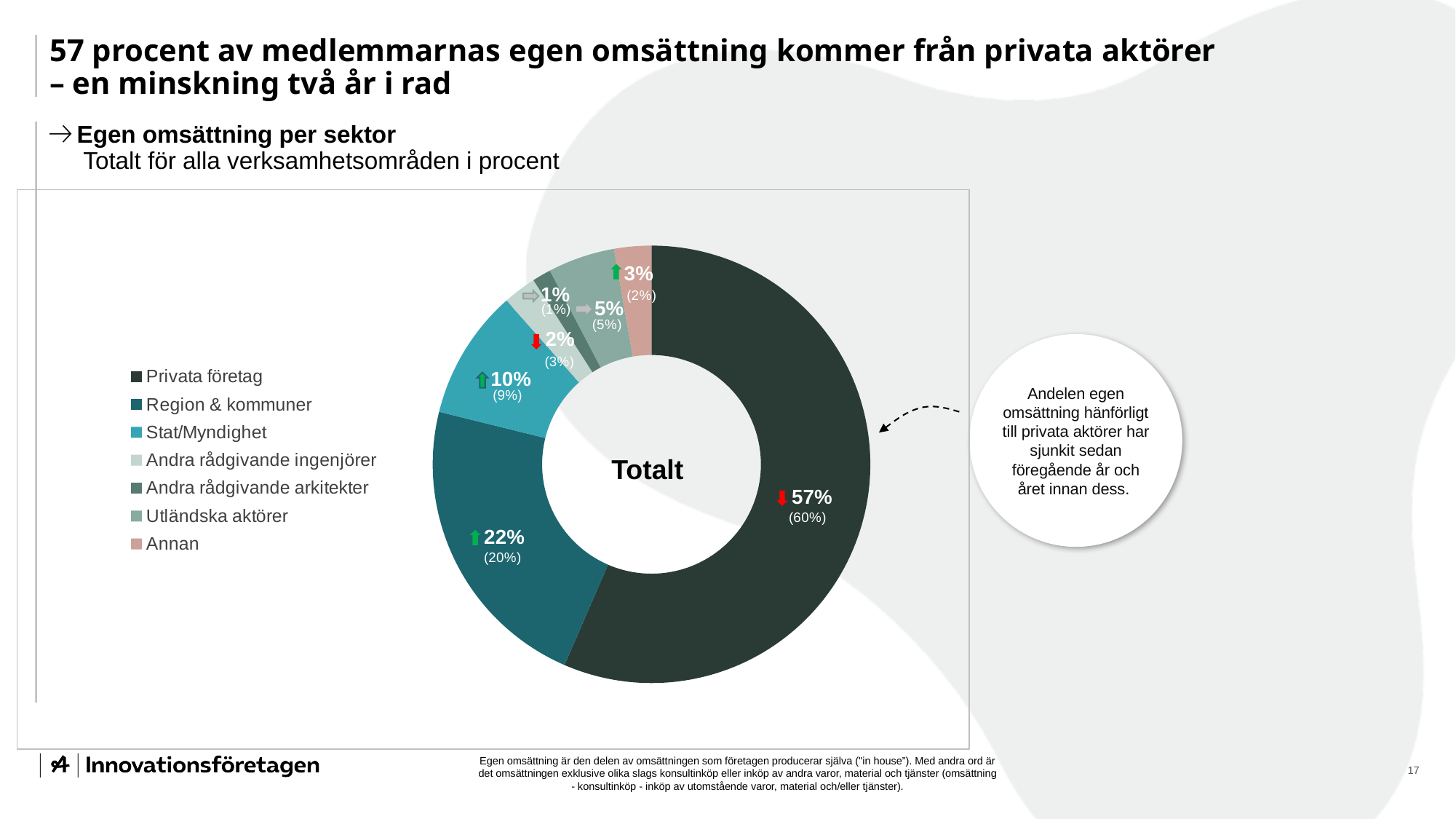
What share of own turnover comes from Region & kommuner? 22% Which is larger, the share for Stat/Myndighet or the share for Utländska aktörer? Stat/Myndighet How many sectors does the legend list? 7 What share of own turnover comes from Stat/Myndighet? 10% What share of own turnover comes from Privata företag? 57% Which sector has the largest share of own turnover? Privata företag What share of own turnover comes from Utländska aktörer? 5% What is the previous-year value shown in parentheses for Privata företag? 60% What word is written in the centre of the donut chart? Totalt What kind of chart is shown on the slide? Pie chart (donut) Which sector has the smallest share of own turnover? Andra rådgivande arkitekter What is the difference in percentage points between Privata företag and Region & kommuner? 35 percentage points